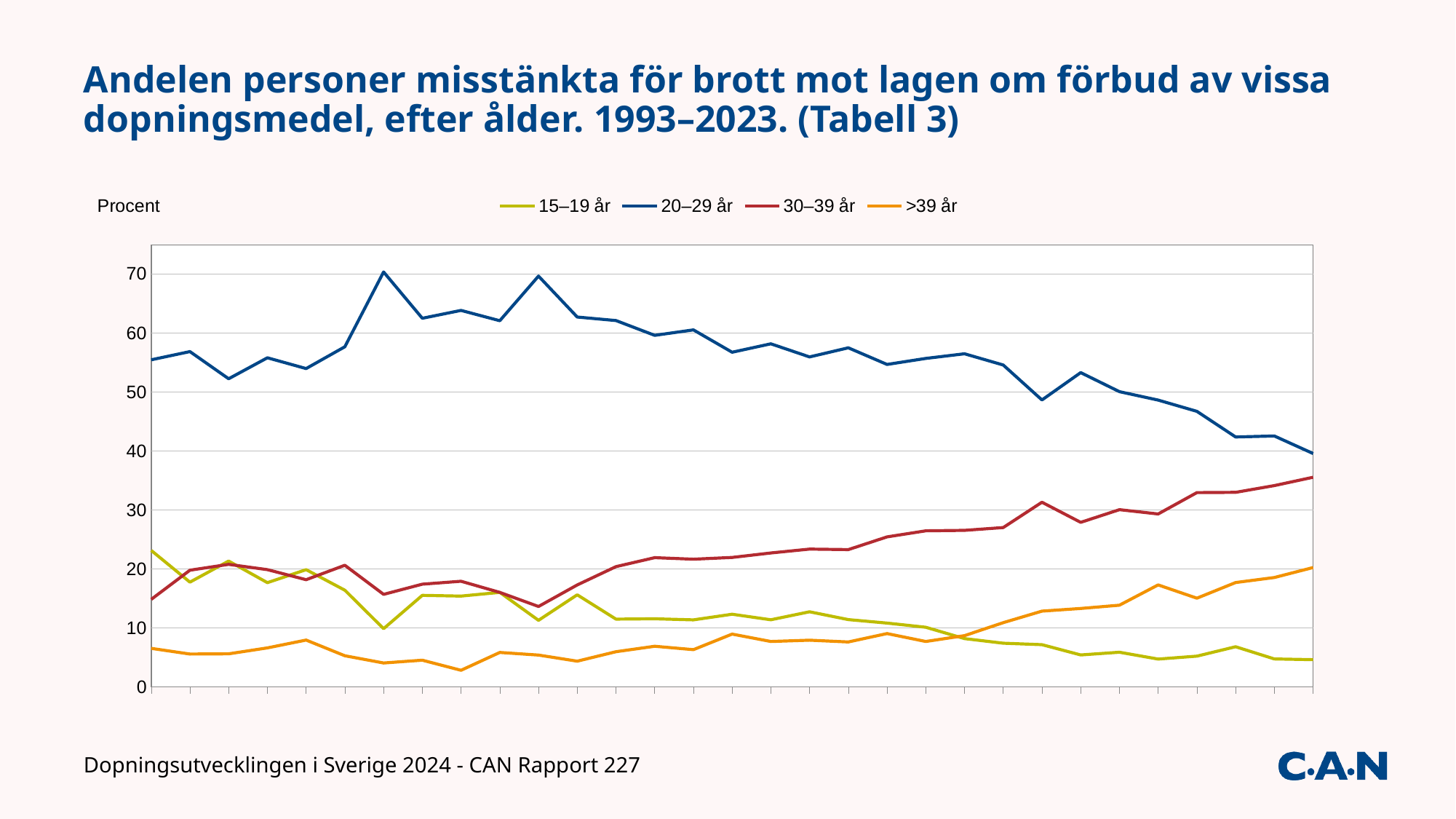
Is the value for 15–19 år at the right end of the chart greater or less than 10? less Which age groups are listed in the legend? 15–19 år, 20–29 år, 30–39 år, >39 år What is the label shown on the y axis? Procent Is the value for 20–29 år at the left end of the chart greater or less than 50? greater Does the line for >39 år rise or fall overall from left to right? rise What kind of chart is shown on the slide? line chart At the right end of the chart, which is larger: the value for 20–29 år or the value for 30–39 år? 20–29 år How many series does the legend list? 4 Does the line for 20–29 år rise or fall overall from left to right? fall Which age group has the lowest value at the right end of the chart? 15–19 år Which age group has the highest values across the whole period? 20–29 år Does the line for 30–39 år rise or fall overall from left to right? rise